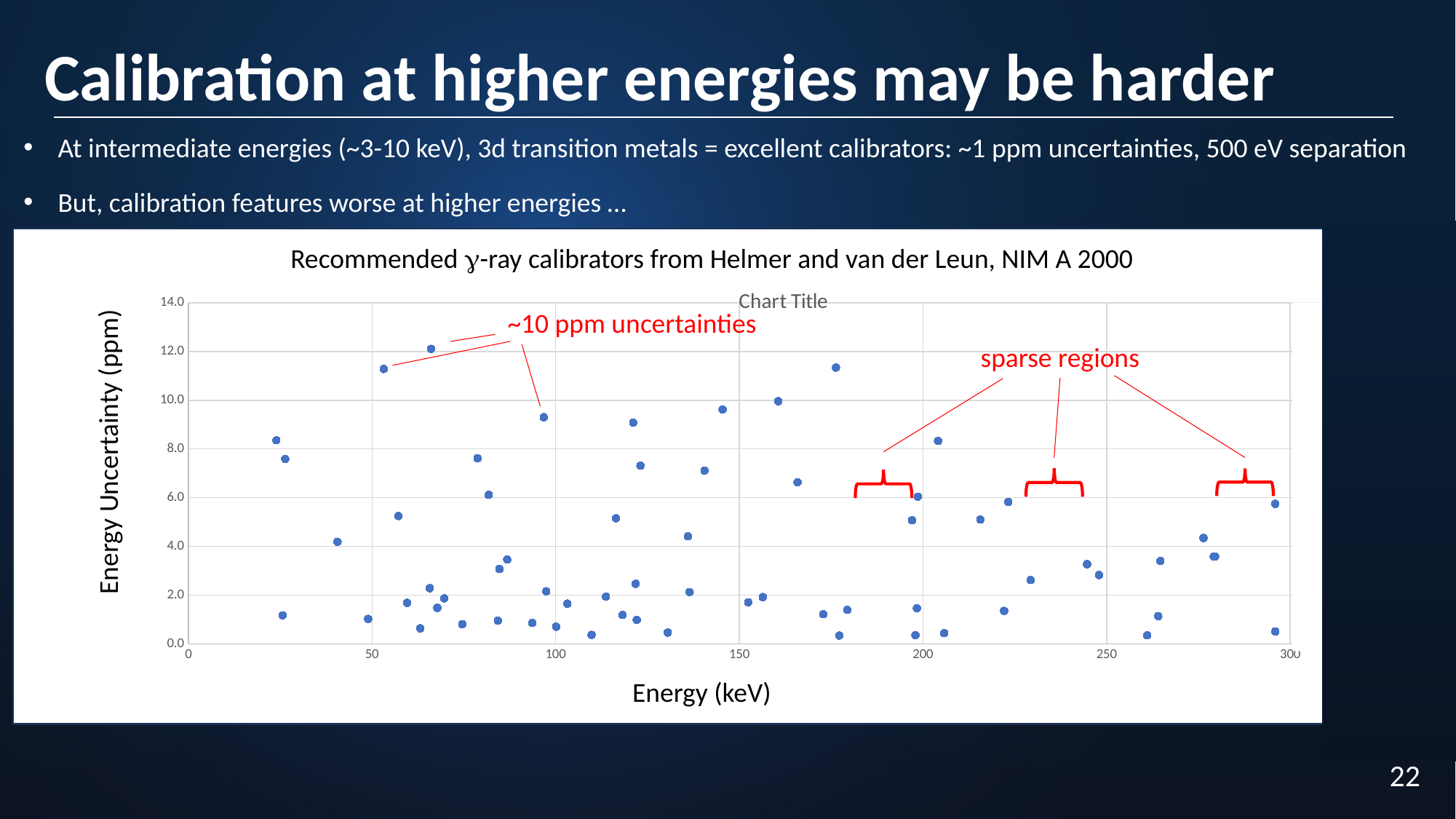
What is the title of the x axis of the chart? Energy (keV) What is the title of the y axis of the chart? Energy Uncertainty (ppm) Is the highest plotted energy uncertainty greater or less than 14.0 ppm? less Is the lowest plotted energy uncertainty greater or less than 2.0 ppm? less Is the highest plotted energy uncertainty greater or less than 10.0 ppm? greater What kind of chart is shown on the slide? scatter chart